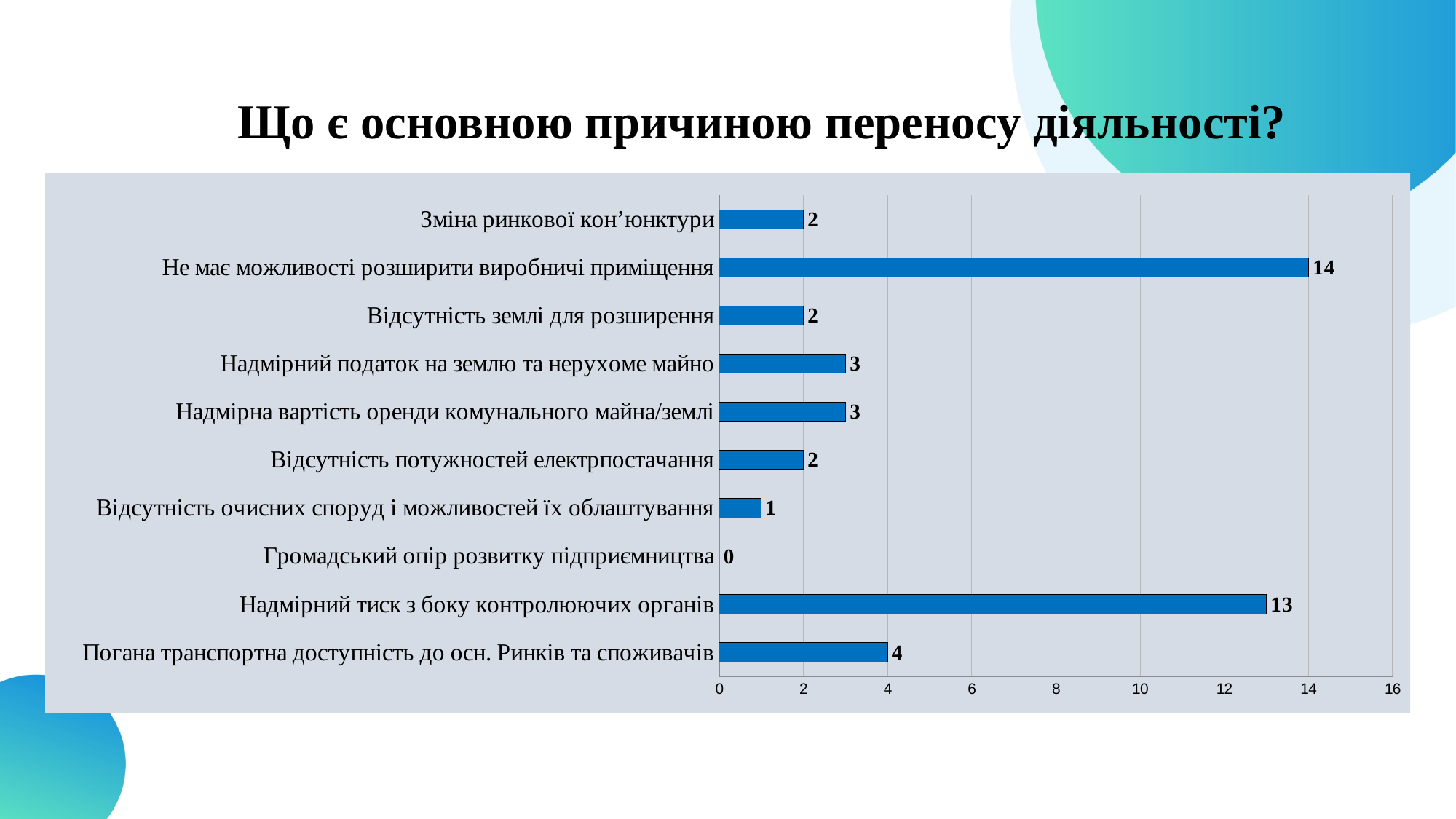
What is the value for "Громадський опір розвитку підприємництва"? 0 How many categories are shown in the chart? 10 What is the value for "Не має можливості розширити виробничі приміщення"? 14 What is the difference between the values for "Не має можливості розширити виробничі приміщення" and "Надмірний тиск з боку контролюючих органів"? 1 Which category has the lowest value? Громадський опір розвитку підприємництва What is the title of the slide? Що є основною причиною переносу діяльності? What kind of chart is shown on the slide? bar chart What is the value for "Надмірний тиск з боку контролюючих органів"? 13 Is the value for "Надмірний тиск з боку контролюючих органів" greater or less than 10? greater Which is larger: the value for "Погана транспортна доступність до осн. Ринків та споживачів" or the value for "Надмірний податок на землю та нерухоме майно"? Погана транспортна доступність до осн. Ринків та споживачів What is the value for "Погана транспортна доступність до осн. Ринків та споживачів"? 4 Which category has the highest value? Не має можливості розширити виробничі приміщення